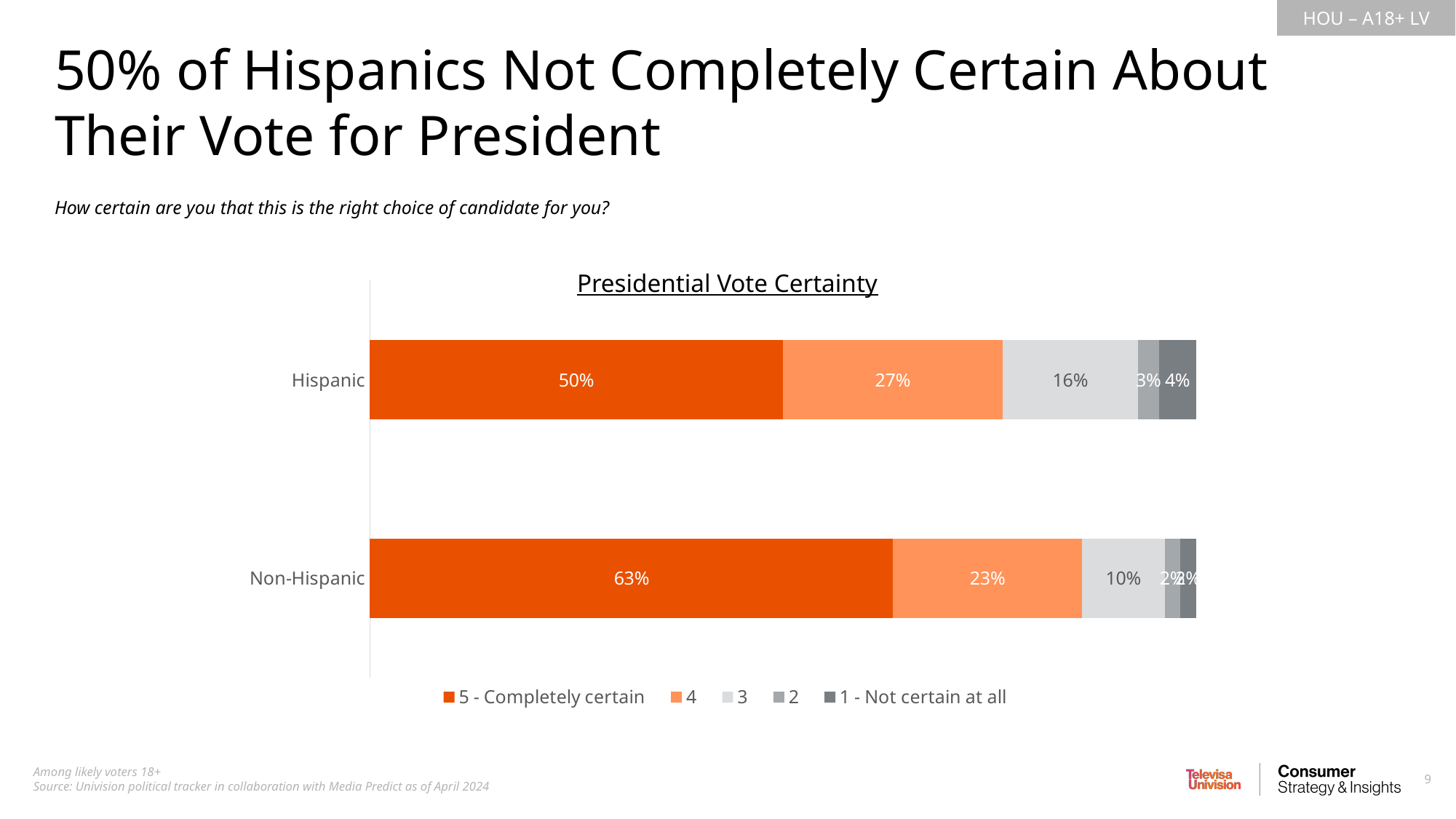
How many groups (categories) are shown on the chart? 2 What percentage of Hispanic likely voters are "5 - Completely certain" about their presidential vote? 50% What is the difference between the Non-Hispanic and Hispanic "5 - Completely certain" percentages? 13 percentage points What type of chart is shown on the slide? Stacked bar chart What is the title of the chart? Presidential Vote Certainty What percentage of Non-Hispanic likely voters are "5 - Completely certain"? 63% Which group has the larger "5 - Completely certain" share, Hispanic or Non-Hispanic? Non-Hispanic What is the value of the "4" segment for Hispanic voters? 27% What percentage of Hispanic voters are "1 - Not certain at all"? 4% What is the value of the "3" segment for Non-Hispanic voters? 10% What is the difference between the Hispanic and Non-Hispanic "3" segments? 6 percentage points How many series does the legend list? 5